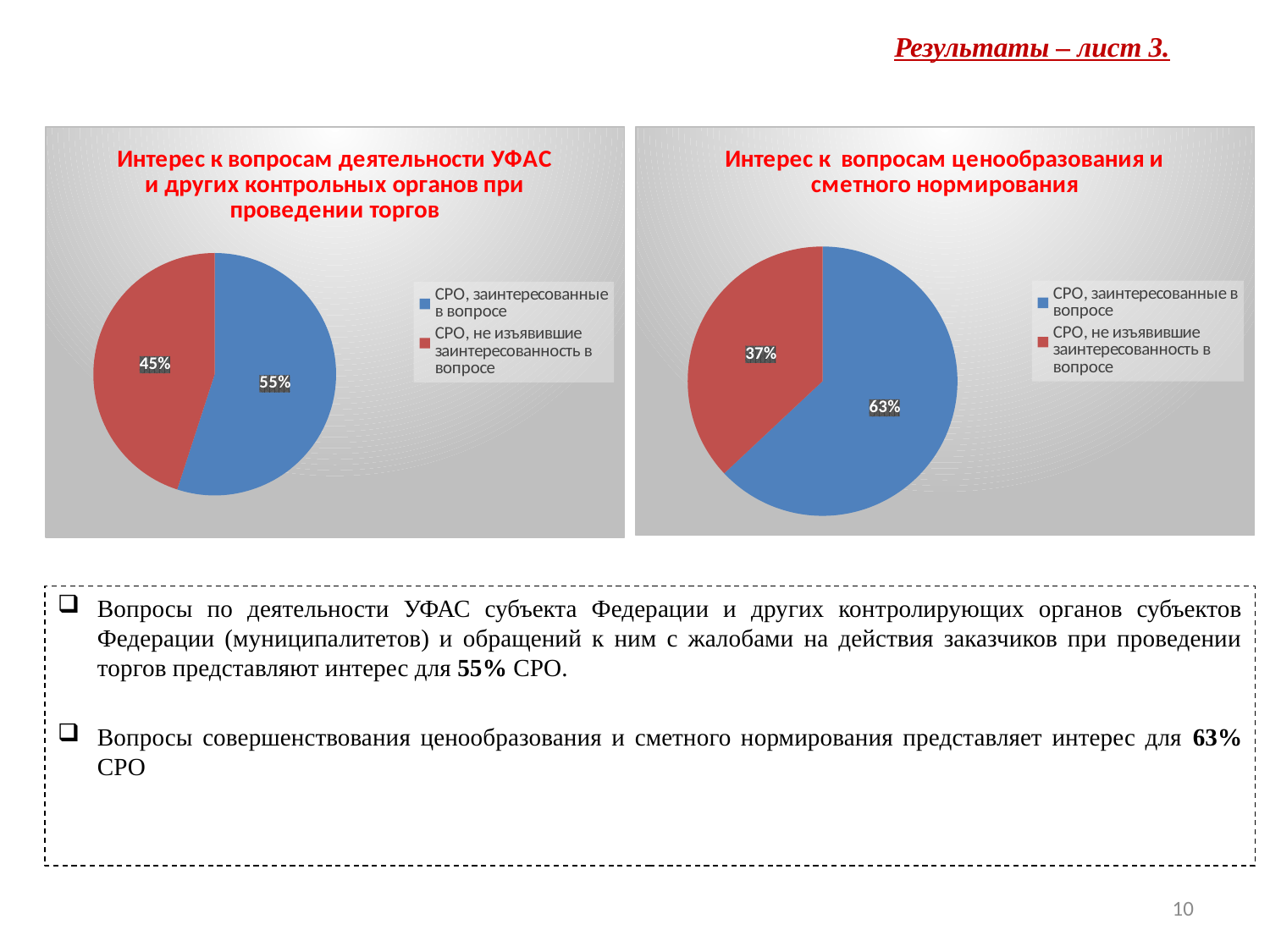
In the right chart, what colour is the slice for 'СРО, не изъявившие заинтересованность в вопросе'? red In the left chart (Интерес к вопросам деятельности УФАС и других контрольных органов при проведении торгов), what share is shown for 'СРО, не изъявившие заинтересованность в вопросе'? 45% Which chart shows a larger share for 'СРО, заинтересованные в вопросе', the left chart or the right chart? the right chart In the right chart, what is the difference between the share of 'СРО, заинтересованные в вопросе' and 'СРО, не изъявившие заинтересованность в вопросе'? 26% In the left chart, what is the difference between the two slices? 10% What type of chart is the left chart? pie chart In the right chart, which category has the smaller slice? СРО, не изъявившие заинтересованность в вопросе In the right chart (Интерес к вопросам ценообразования и сметного нормирования), what share is shown for 'СРО, заинтересованные в вопросе'? 63% In the left chart (Интерес к вопросам деятельности УФАС и других контрольных органов при проведении торгов), what share is shown for 'СРО, заинтересованные в вопросе'? 55% In the left chart, which category has the larger slice? СРО, заинтересованные в вопросе In the right chart (Интерес к вопросам ценообразования и сметного нормирования), what share is shown for 'СРО, не изъявившие заинтересованность в вопросе'? 37% How many categories does the right chart's legend list? 2